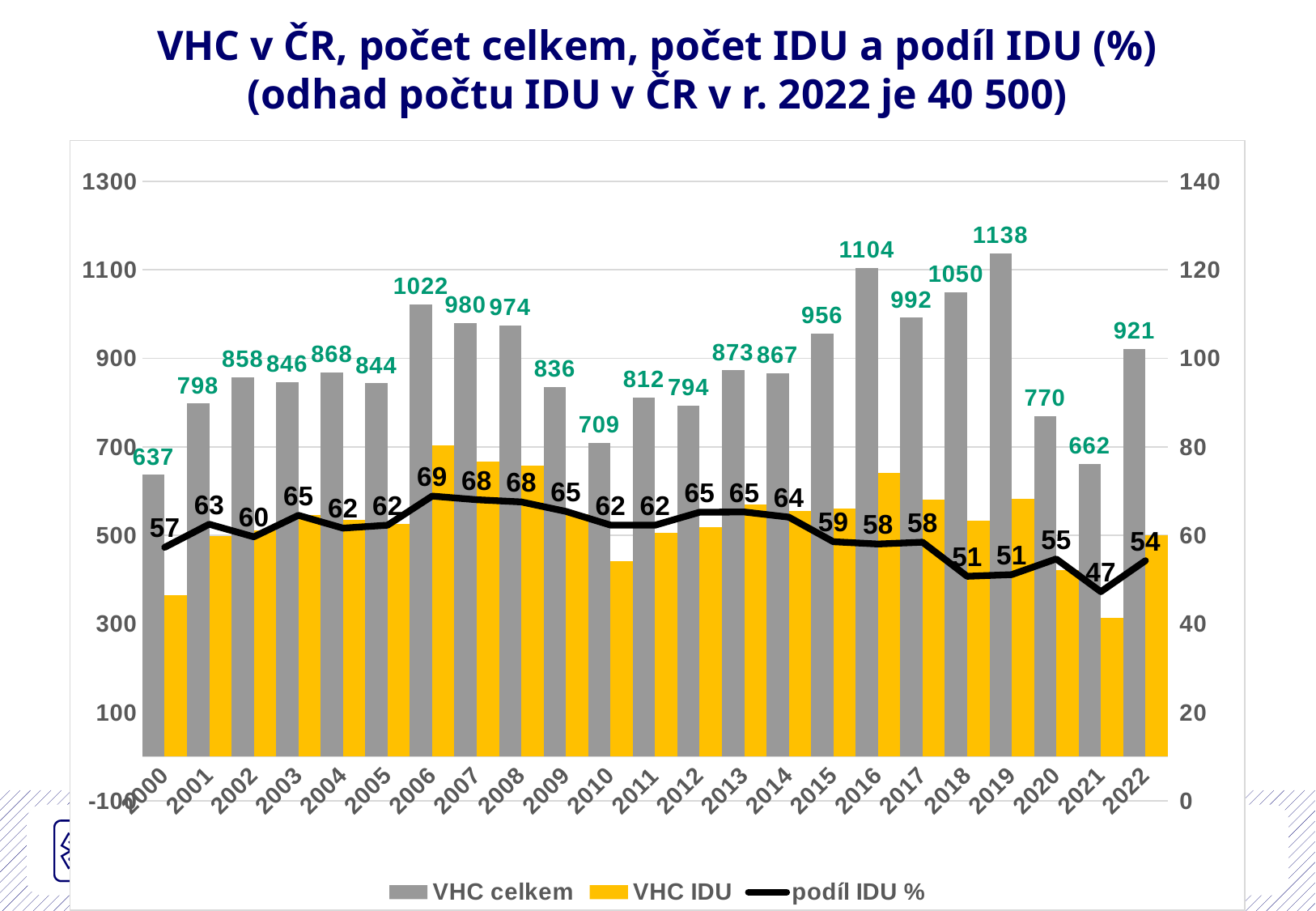
What is the value of VHC celkem for 2019? 1138 What is the difference between VHC celkem in 2019 and in 2000? 501 Which year has a higher VHC celkem value, 2016 or 2017? 2016 What is the value of VHC celkem for 2000? 637 How many years are shown on the x axis? 23 In which year is podíl IDU % lowest? 2021 Is the VHC IDU value for 2000 greater or less than 500? less How many series does the legend list? 3 Does podíl IDU % rise or fall from 2016 to 2021? fall In which year is VHC celkem highest? 2019 What is the podíl IDU % value for 2021? 47 What is the podíl IDU % value for 2006? 69